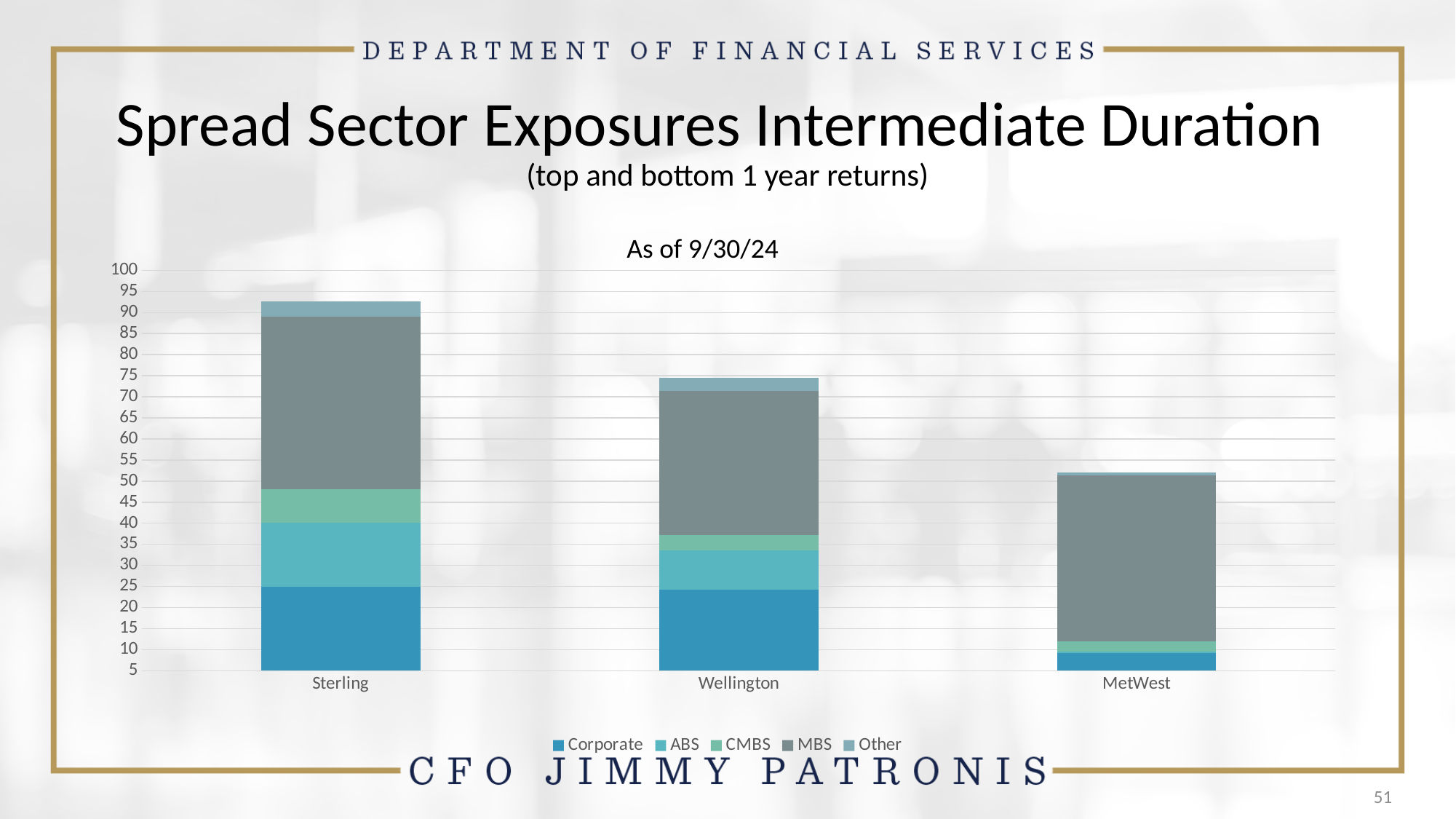
Is the total stacked bar for MetWest greater or less than 60? less What kind of chart is shown on the slide? Stacked bar chart How many series does the chart's legend list? 5 Is the total stacked bar for Sterling greater or less than 85? greater Is the total stacked bar for Wellington greater or less than 80? less How many managers (categories) are shown on the x axis of the chart? 3 Which has a larger total stacked bar, Wellington or MetWest? Wellington Which manager has the highest total stacked bar? Sterling Do the total stacked bar heights rise or fall moving from Sterling to MetWest along the x axis? fall Which manager has the lowest total stacked bar? MetWest As of what date is the chart's data shown? 9/30/24 Which series is listed first in the chart's legend? Corporate